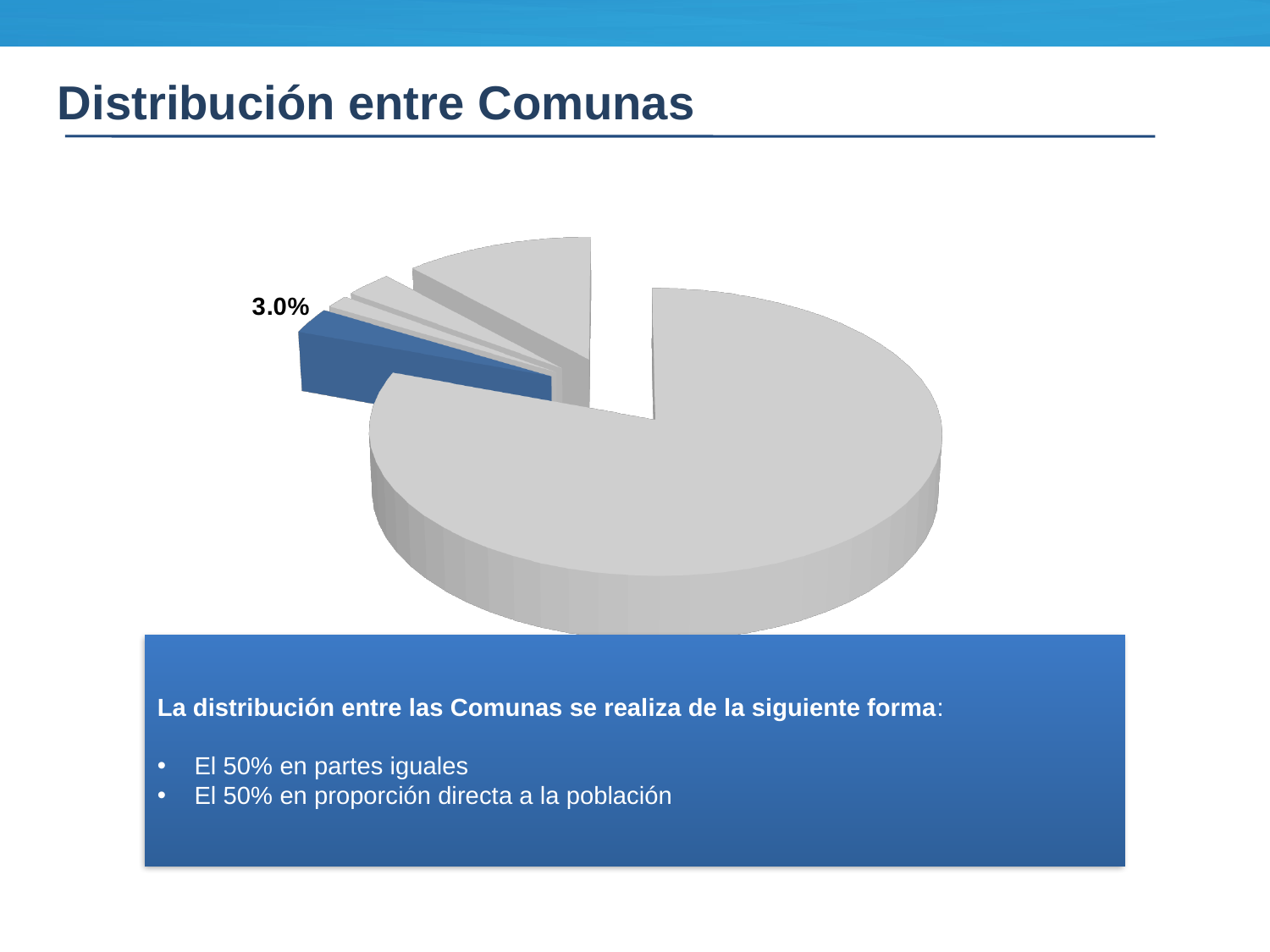
What kind of chart is shown on the slide? pie chart What colour is the slice labelled 3.0%? blue Is the value of the blue slice greater or less than 10%? less What value is printed on the blue slice of the pie chart? 3.0% Is the blue slice larger or smaller than the largest grey slice? smaller Does the largest slice of the pie represent more or less than half of the pie? more How many data labels are printed on the pie chart? 1